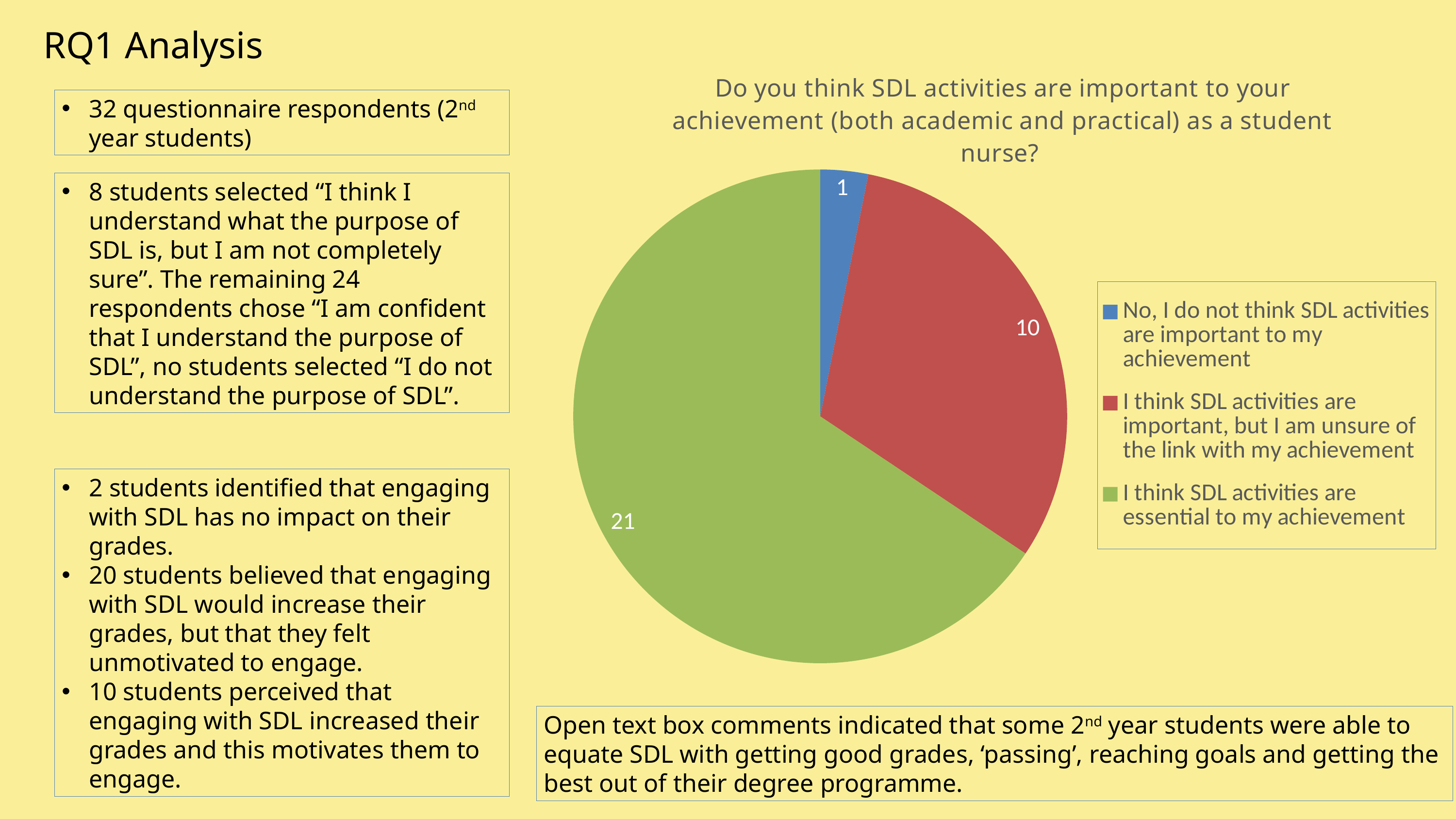
What type of chart is shown on the slide? pie chart How many respondents selected "I think SDL activities are essential to my achievement"? 21 How many respondents selected "I think SDL activities are important, but I am unsure of the link with my achievement"? 10 How many respondents selected "No, I do not think SDL activities are important to my achievement"? 1 Which response option has the largest slice of the pie? I think SDL activities are essential to my achievement What is the total number of responses shown across all slices of the pie chart? 32 What fraction of all responses does the "essential to my achievement" slice represent? 21 out of 32 What is the difference between the number who think SDL activities are essential and the number who are unsure of the link with their achievement? 11 Which response option has the smallest slice of the pie? No, I do not think SDL activities are important to my achievement Which is larger: the slice for "important, but unsure of the link" or the slice for "not important"? I think SDL activities are important, but I am unsure of the link with my achievement How many slices does the pie chart have? 3 What colour is the slice for "I think SDL activities are essential to my achievement"? green